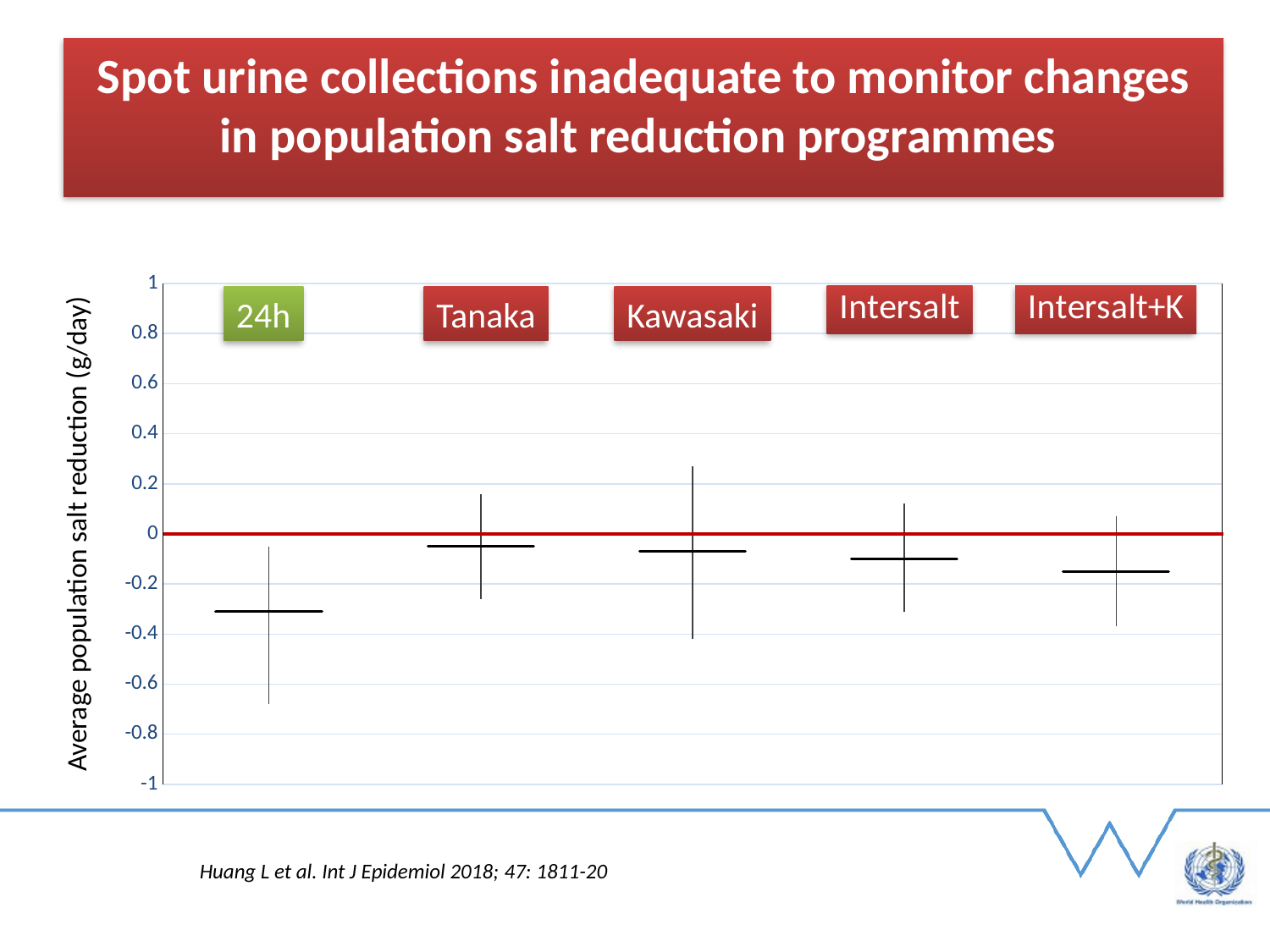
How many methods (categories) are plotted on the chart? 5 Which category has the lowest average population salt reduction? 24h Is the value for 24h greater or less than -0.2? less Is the value for Intersalt greater or less than 0? less Which is larger, the value for Tanaka or the value for Intersalt+K? Tanaka Which is larger, the value for 24h or the value for Intersalt+K? Intersalt+K Is the value for Tanaka greater or less than -0.2? greater What is the label of the y axis? Average population salt reduction (g/day) At what y-axis value is the red horizontal line drawn? 0 What is the title of the slide containing the chart? Spot urine collections inadequate to monitor changes in population salt reduction programmes